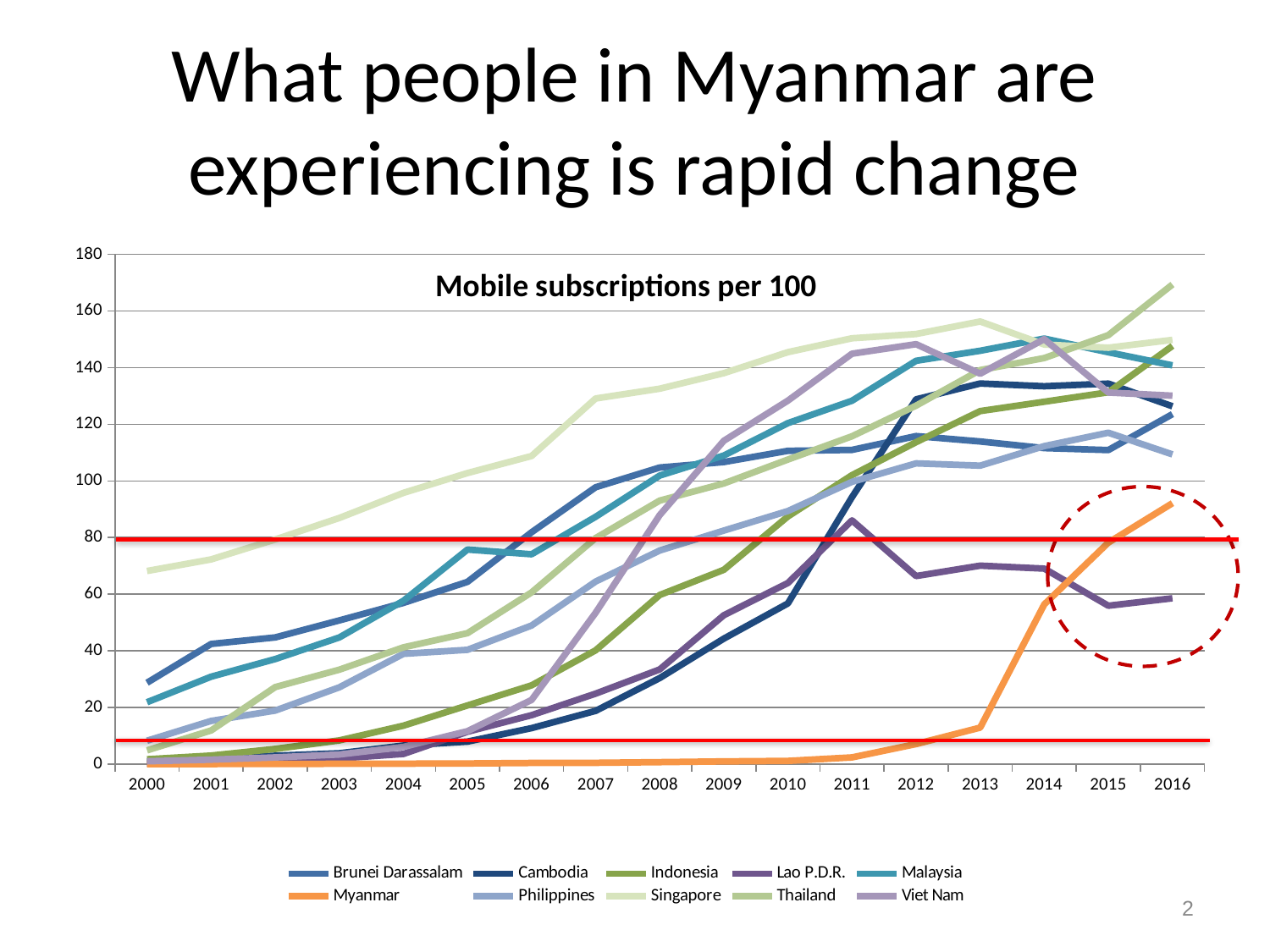
Is the value for Myanmar in 2013 greater or less than 20? less Does the value for Myanmar rise or fall from 2012 to 2016? rise Which country has the highest value in 2000? Singapore In 2016, which is larger, the value for Myanmar or the value for Lao P.D.R.? Myanmar What kind of chart is shown on the slide? line chart How many years are shown along the x axis? 17 Which country has the lowest value in 2016? Lao P.D.R. Is the value for Singapore in 2013 greater or less than 140? greater What is the title of the chart? Mobile subscriptions per 100 How many series does the legend list? 10 Which country has the highest value in 2016? Thailand Is the value for Myanmar in 2016 greater or less than 80? greater